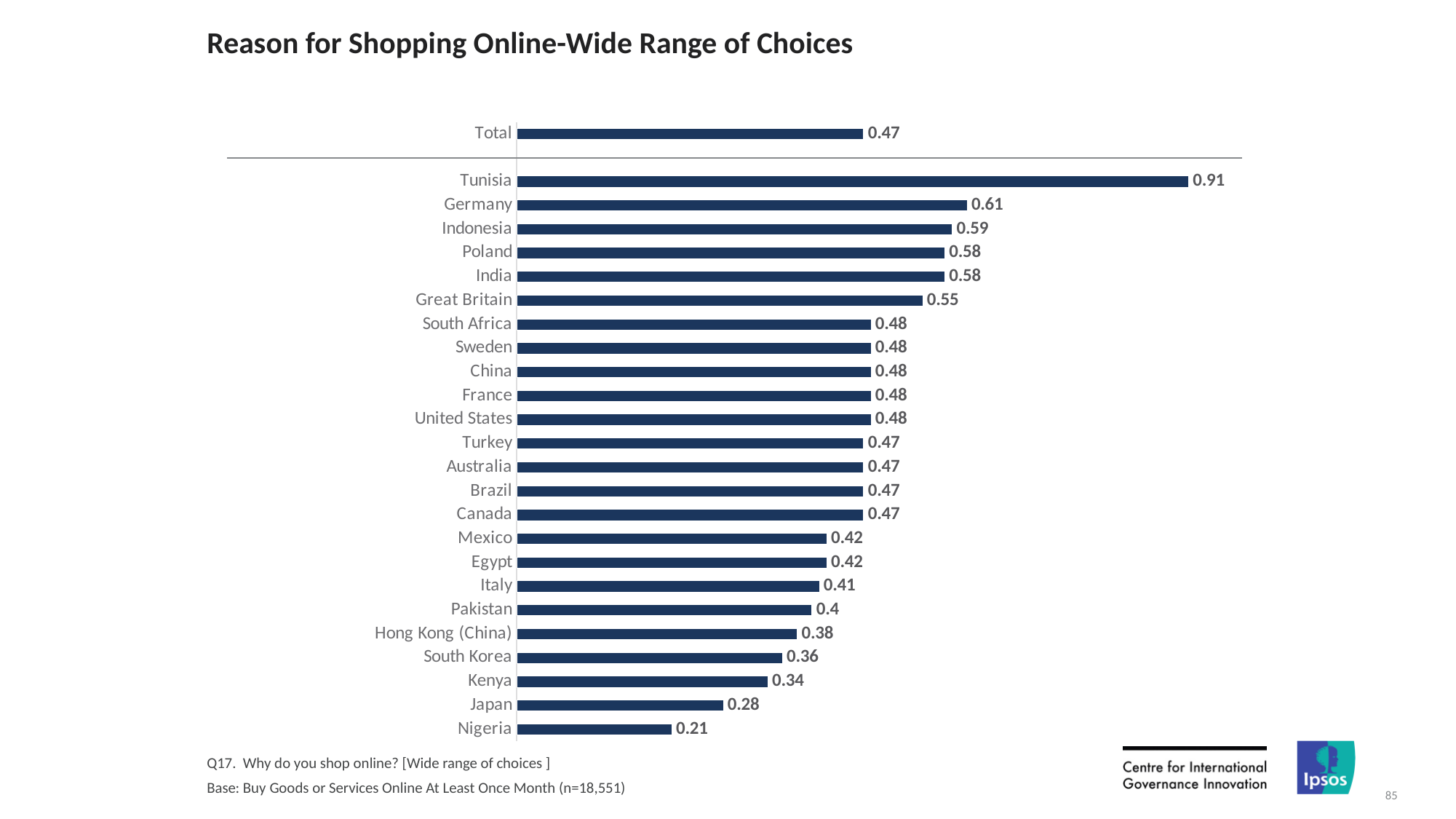
Which has a larger value, Indonesia or Kenya? Indonesia Which country has the lowest value? Nigeria What is the difference between the values for Tunisia and Germany? 0.3 What is the value for Japan? 0.28 What is the value for Hong Kong (China)? 0.38 Which country has the highest value? Tunisia What is the difference between the values for Great Britain and Nigeria? 0.34 What kind of chart is shown on the slide? Bar chart What is the value for Total? 0.47 What is the title of the chart? Reason for Shopping Online-Wide Range of Choices How many countries are listed below the Total bar? 24 What is the value for Tunisia? 0.91